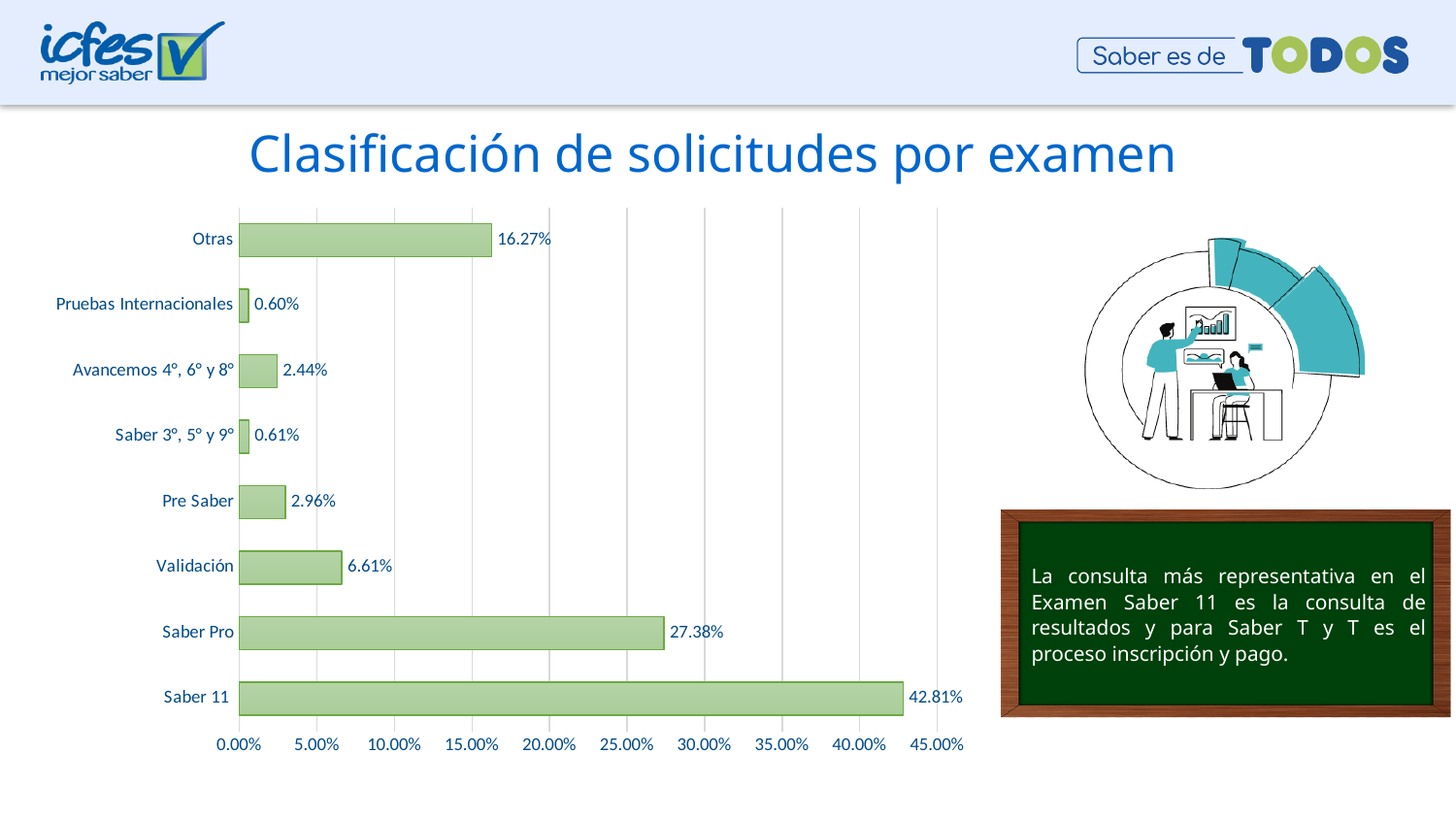
What is the value for Saber Pro? 27.38% What is the value for Avancemos 4°, 6° y 8°? 2.44% What is the difference between the values for Saber 11 and Saber Pro? 15.43% Which is larger, the value for Otras or the value for Validación? Otras What is the value for Otras? 16.27% What is the value for Validación? 6.61% How many categories are shown in the chart? 8 Is the value for Saber Pro greater or less than 25.00%? greater What is the value for Saber 11? 42.81% What is the title of the chart? Clasificación de solicitudes por examen What type of chart is shown on the slide? Bar chart Which category has the highest value? Saber 11